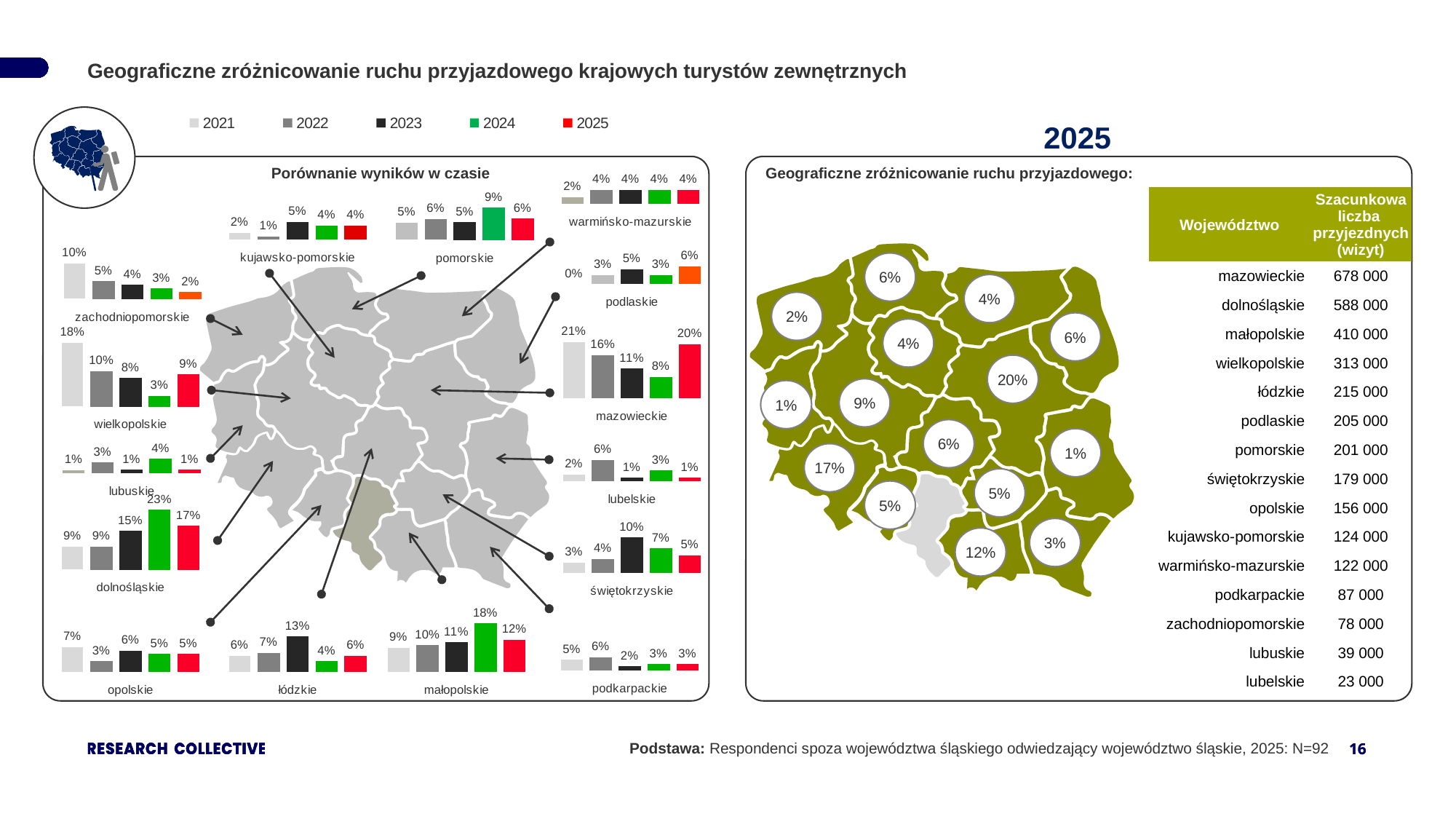
In the 'Porównanie wyników w czasie' chart, which year has the lowest value for łódzkie? 2024 In the 'Porównanie wyników w czasie' chart, what is the value for podlaskie in 2021? 0% In the 'Porównanie wyników w czasie' chart, which year has the highest value for wielkopolskie? 2021 How many series does the legend of the 'Porównanie wyników w czasie' chart list? 5 In the 'Porównanie wyników w czasie' chart, what is the value for mazowieckie in 2025? 20% In the 'Porównanie wyników w czasie' chart, what is the value for dolnośląskie in 2024? 23% In the 'Porównanie wyników w czasie' chart, what is the value for małopolskie in 2023? 11% In the 'Porównanie wyników w czasie' chart, which colour represents the 2024 series in the legend? Green In the 'Porównanie wyników w czasie' chart, do the values for zachodniopomorskie rise or fall from 2021 to 2025? Fall In the 'Porównanie wyników w czasie' chart, which is larger for świętokrzyskie: the 2023 value or the 2025 value? 2023 What kind of chart is used for each voivodeship in the 'Porównanie wyników w czasie' panel? Bar chart In the 'Porównanie wyników w czasie' chart, what is the difference between the 2021 and 2025 values for zachodniopomorskie? 8%